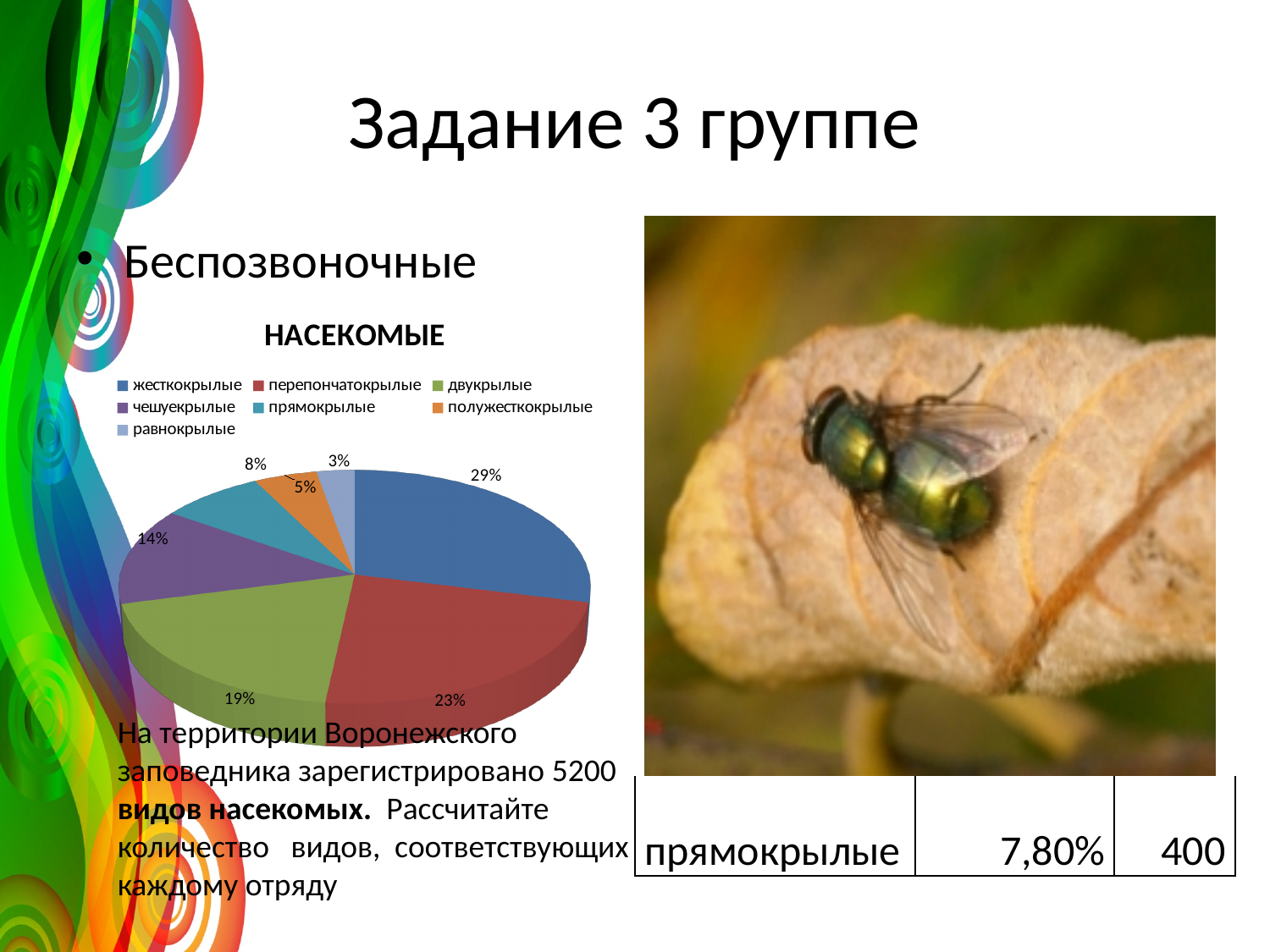
Which category has the smallest slice of the pie? равнокрылые What share of the pie does чешуекрылые have? 14% How many categories does the legend of the pie chart list? 7 What share of the pie does равнокрылые have? 3% Which category has the largest slice of the pie? жесткокрылые What kind of chart is shown under the heading НАСЕКОМЫЕ? pie chart What share of the pie does перепончатокрылые have? 23% What is the difference in percentage points between жесткокрылые and перепончатокрылые? 6 What share of the pie does жесткокрылые have? 29% Which slice is larger, прямокрылые or полужесткокрылые? прямокрылые What is the title of the pie chart? НАСЕКОМЫЕ What share of the pie does двукрылые have? 19%